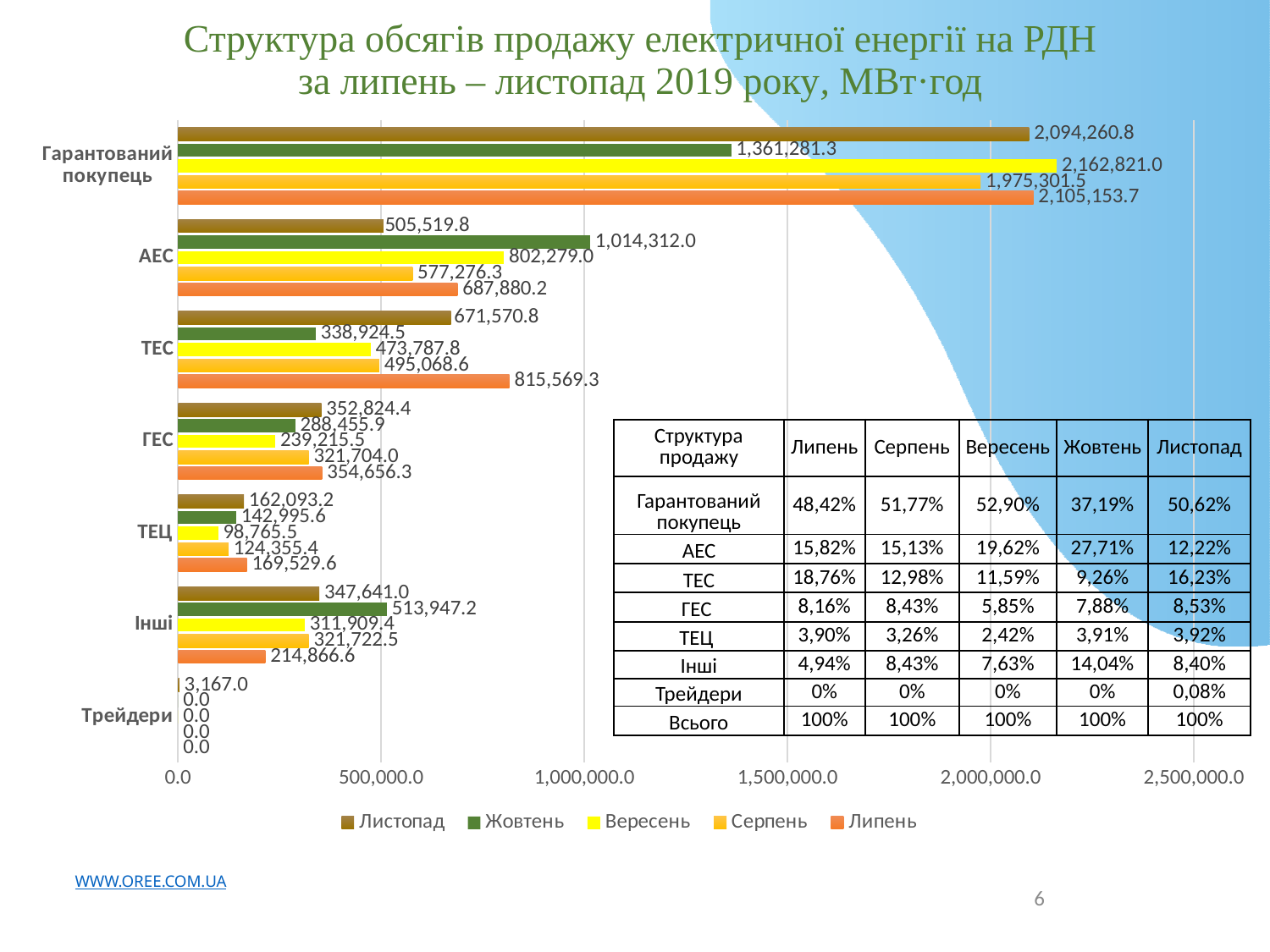
What is the difference between the Жовтень and Листопад values for АЕС? 508,792.2 Which month has the lowest value for Гарантований покупець? Жовтень Which month has the highest value for Гарантований покупець? Вересень Which is larger for ТЕЦ: the Липень value or the Вересень value? Липень How many series does the chart legend list? 5 What is the value for АЕС in the Жовтень series? 1,014,312.0 What is the value for Трейдери in the Листопад series? 3,167.0 Is the Липень value for ТЕС greater or less than 1,000,000.0? less What is the value for Гарантований покупець in the Вересень series? 2,162,821.0 What is the value for ТЕС in the Липень series? 815,569.3 What kind of chart is shown on the slide? bar chart How many categories are shown on the vertical axis of the chart? 7